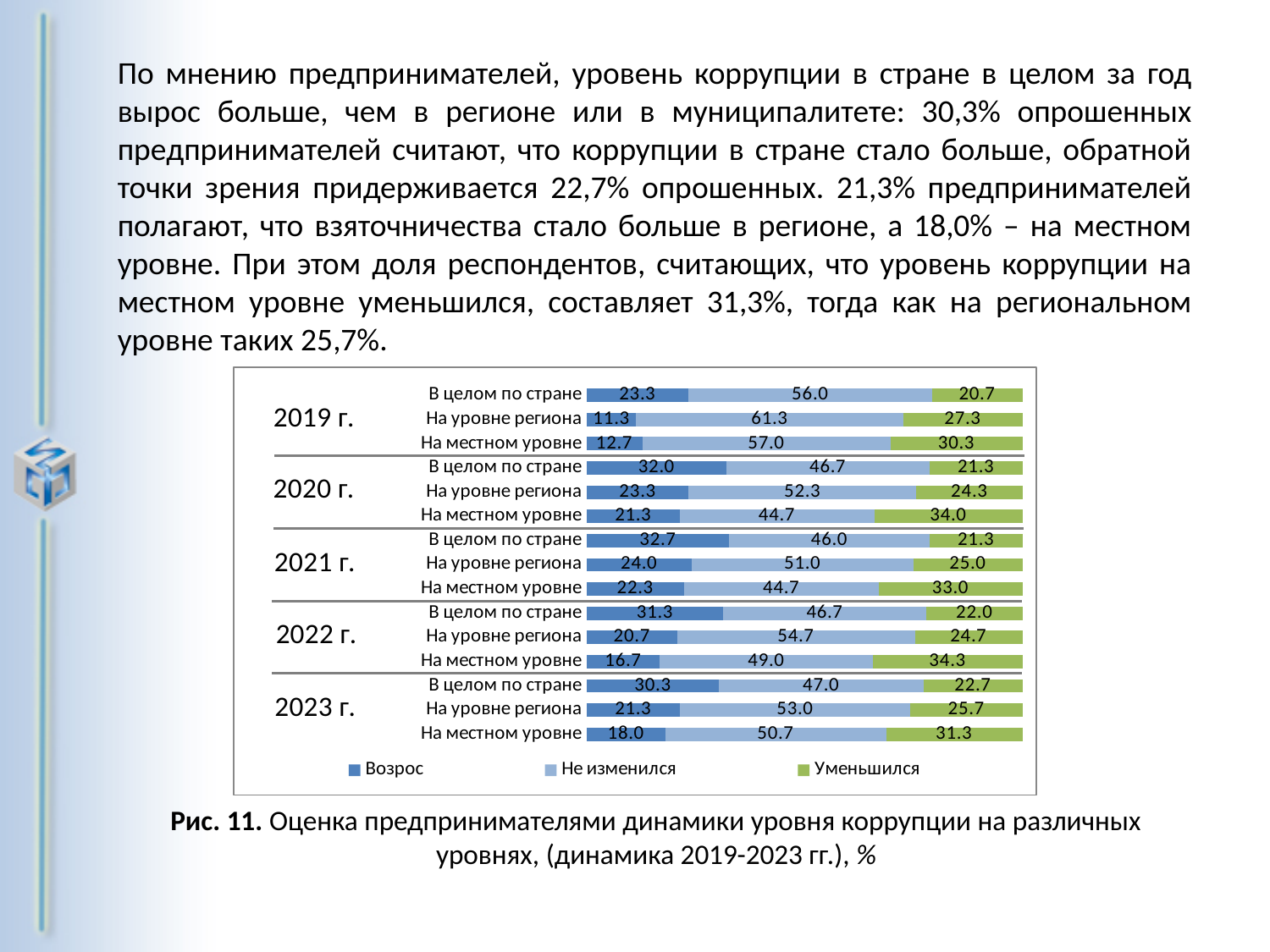
What is the value of 'Уменьшился' for 'На местном уровне' in 2022 г.? 34.3 What is the value of 'Возрос' for 'В целом по стране' in 2023 г.? 30.3 What is the total of the stacked bar for 'На местном уровне' in 2023 г.? 100.0 What type of chart is shown on the slide? Stacked bar chart Which year has the lowest 'Возрос' value for 'На уровне региона'? 2019 г. In 2020 г., which is larger: 'Возрос' for 'В целом по стране' or 'Возрос' for 'На местном уровне'? В целом по стране How many bars are plotted in the chart? 15 What is the value of 'Не изменился' for 'На уровне региона' in 2019 г.? 61.3 How many series does the legend list? 3 What are the three series named in the legend? Возрос, Не изменился, Уменьшился What is the difference between the 'Уменьшился' values for 'На местном уровне' and 'На уровне региона' in 2023 г.? 5.6 Which year has the highest 'Возрос' value for 'В целом по стране'? 2021 г.